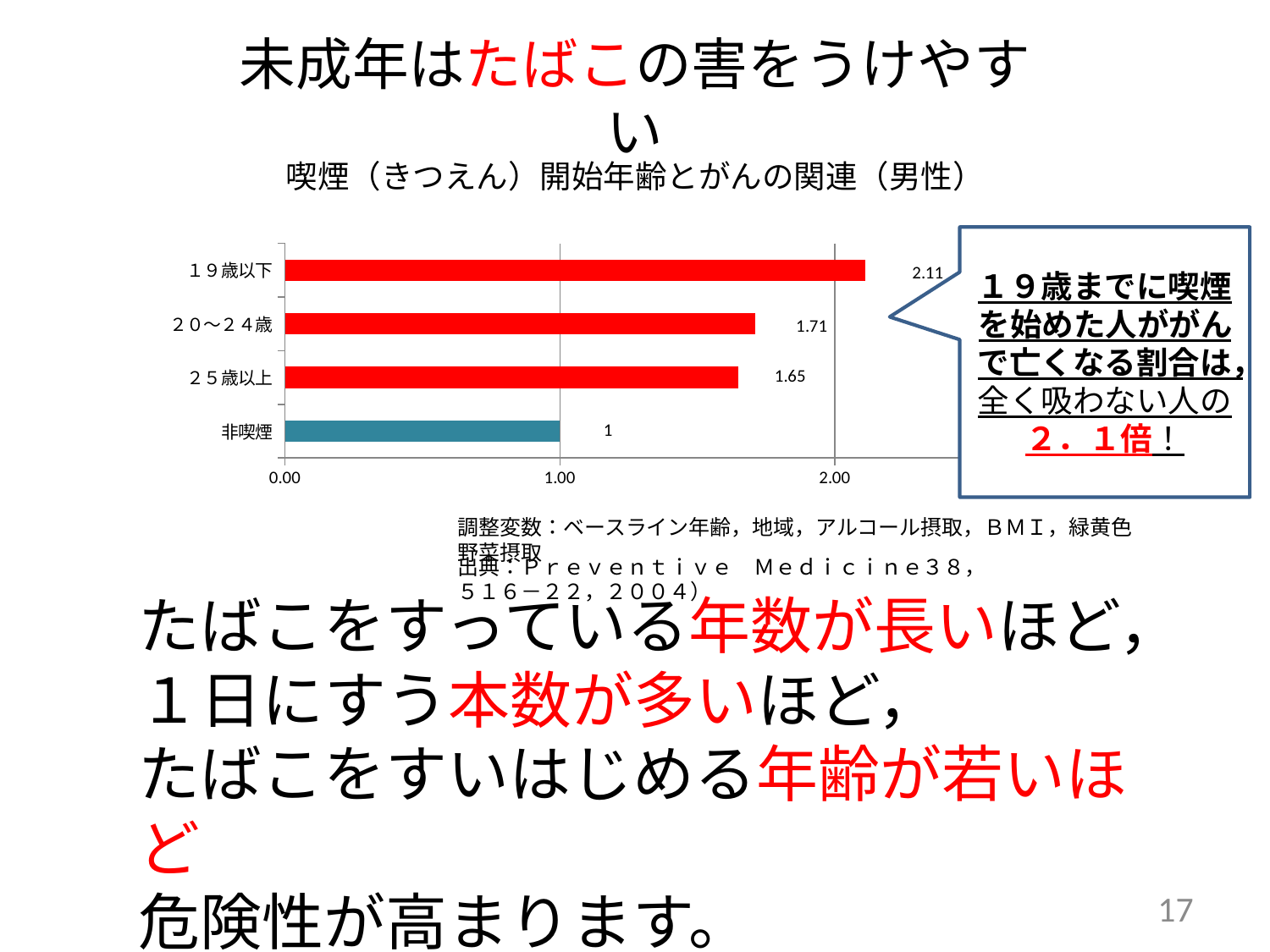
What is the value for 19歳以下? 2.11 What is the value for 25歳以上? 1.65 What is the difference between the values for 20～24歳 and 25歳以上? 0.06 Which category has the highest value? 19歳以下 Which is larger, the value for 19歳以下 or the value for 20～24歳? 19歳以下 What is the value for 非喫煙? 1 Which category has the lowest value? 非喫煙 What is the difference between the values for 19歳以下 and 非喫煙? 1.11 How many categories are shown in the chart? 4 What is the value for 20～24歳? 1.71 Is the value for 25歳以上 greater or less than 1.00? greater What kind of chart is shown on the slide? bar chart